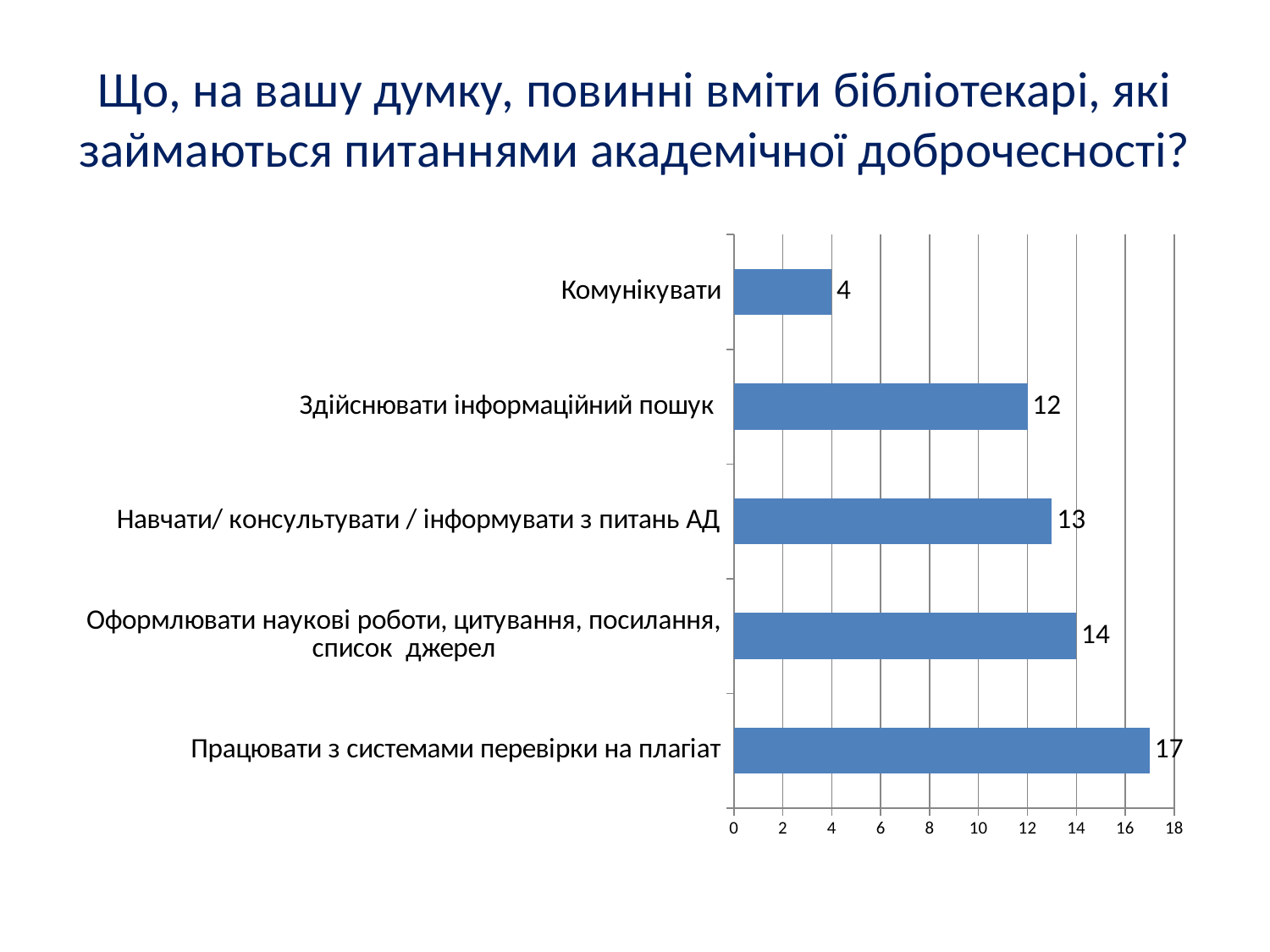
What kind of chart is shown on the slide? Bar chart Which category has the highest value? Працювати з системами перевірки на плагіат Which is larger: the value for "Здійснювати інформаційний пошук" or the value for "Комунікувати"? Здійснювати інформаційний пошук What is the value for "Комунікувати"? 4 What is the difference between the values for "Навчати/ консультувати / інформувати з питань АД" and "Здійснювати інформаційний пошук"? 1 Which category has the lowest value? Комунікувати How many categories are shown in the chart? 5 What is the value for "Здійснювати інформаційний пошук"? 12 What is the maximum value shown on the horizontal axis? 18 What is the difference between the values for "Працювати з системами перевірки на плагіат" and "Комунікувати"? 13 What is the value for "Оформлювати наукові роботи, цитування, посилання, список джерел"? 14 What is the value for "Працювати з системами перевірки на плагіат"? 17